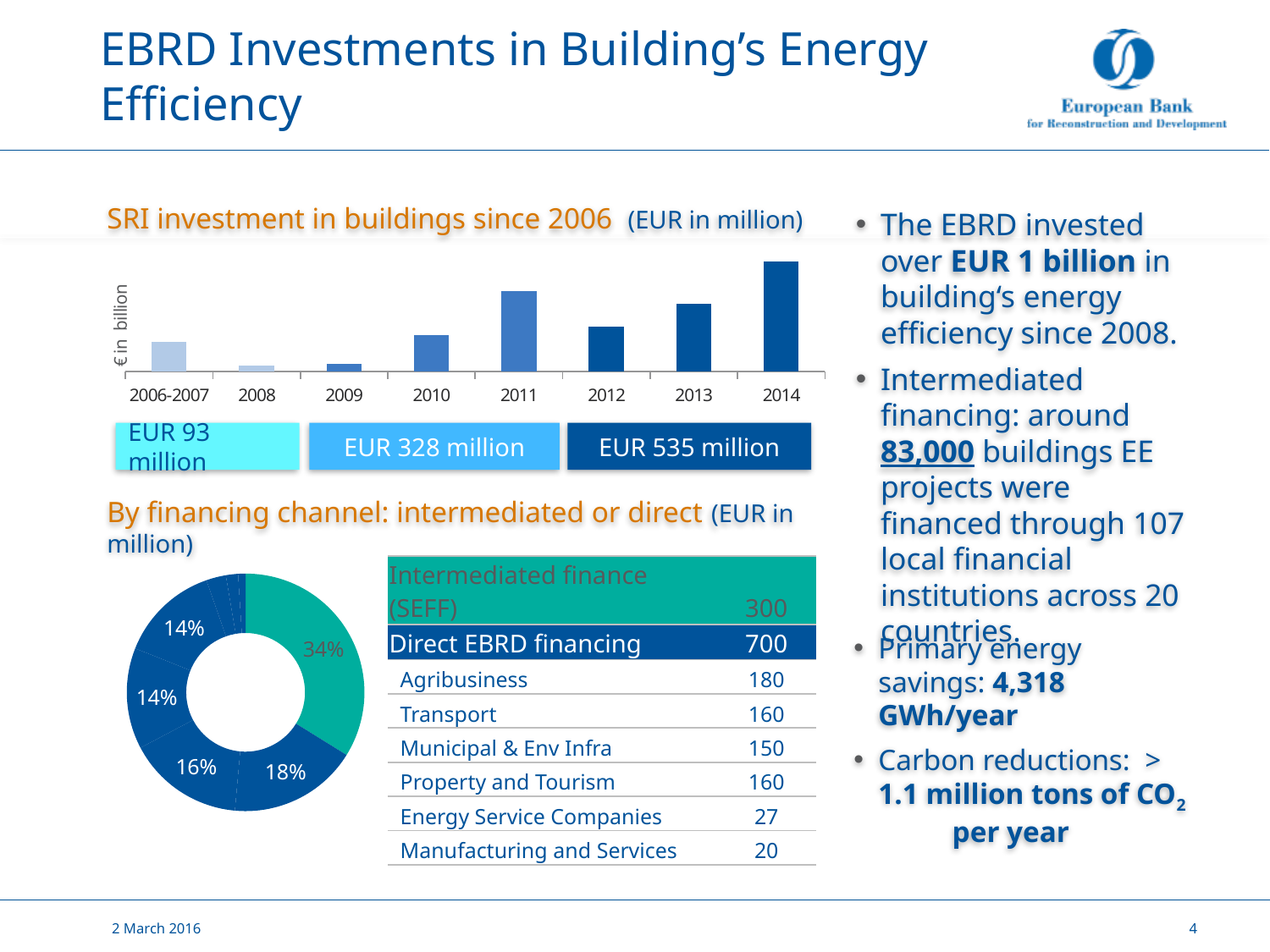
In the table next to the 'By financing channel' pie chart, what is the value for Direct EBRD financing? 700 In the 'SRI investment in buildings since 2006' chart, do the values rise or fall from 2008 to 2011? rise In the 'SRI investment in buildings since 2006' chart, which year has the lowest bar? 2008 What kind of chart is the 'By financing channel: intermediated or direct' chart? doughnut chart In the 'SRI investment in buildings since 2006' chart, which year has the highest bar? 2014 In the table next to the 'By financing channel' pie chart, what is the difference between Direct EBRD financing and Intermediated finance (SEFF)? 400 In the 'SRI investment in buildings since 2006' chart, which is larger, the value for 2010 or the value for 2013? 2013 In the 'SRI investment in buildings since 2006' chart, which is larger, the value for 2011 or the value for 2012? 2011 In the 'By financing channel' pie chart, what is the share of the largest labelled slice? 34% In the 'SRI investment in buildings since 2006' chart, what total is shown in the box under the 2013 and 2014 bars? EUR 535 million What kind of chart is the 'SRI investment in buildings since 2006' chart? bar chart How many categories are shown on the x axis of the 'SRI investment in buildings since 2006' chart? 8